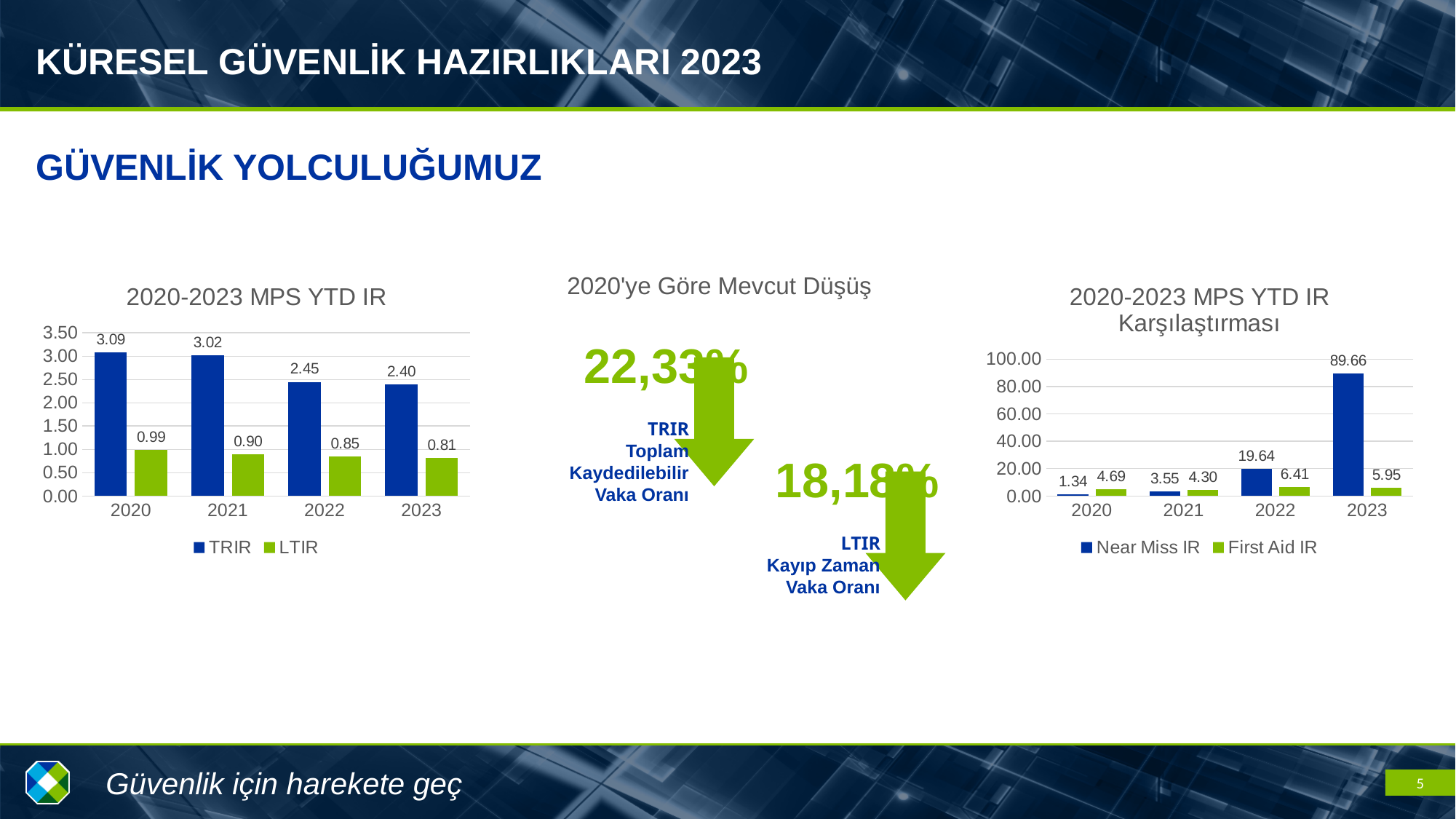
In the chart titled '2020-2023 MPS YTD IR Karşılaştırması', what is the First Aid IR value for 2022? 6.41 In the chart titled '2020-2023 MPS YTD IR', do the TRIR values rise or fall from 2020 to 2023? fall In the chart titled '2020-2023 MPS YTD IR Karşılaştırması', what is the difference between the Near Miss IR values for 2023 and 2022? 70.02 In the chart titled '2020-2023 MPS YTD IR', how many series does the legend list? 2 In the chart titled '2020-2023 MPS YTD IR', which year has the lowest LTIR value? 2023 In the chart titled '2020-2023 MPS YTD IR', what is the difference between the TRIR values for 2020 and 2023? 0.69 In the chart titled '2020-2023 MPS YTD IR', what is the TRIR value for 2023? 2.40 In the chart titled '2020-2023 MPS YTD IR', what is the LTIR value for 2021? 0.90 In the chart titled '2020-2023 MPS YTD IR', which year has the highest TRIR value? 2020 In the chart titled '2020-2023 MPS YTD IR Karşılaştırması', what is the Near Miss IR value for 2023? 89.66 In the chart titled '2020-2023 MPS YTD IR Karşılaştırması', which is larger in 2020: Near Miss IR or First Aid IR? First Aid IR What kind of chart is the one titled '2020-2023 MPS YTD IR Karşılaştırması'? bar chart